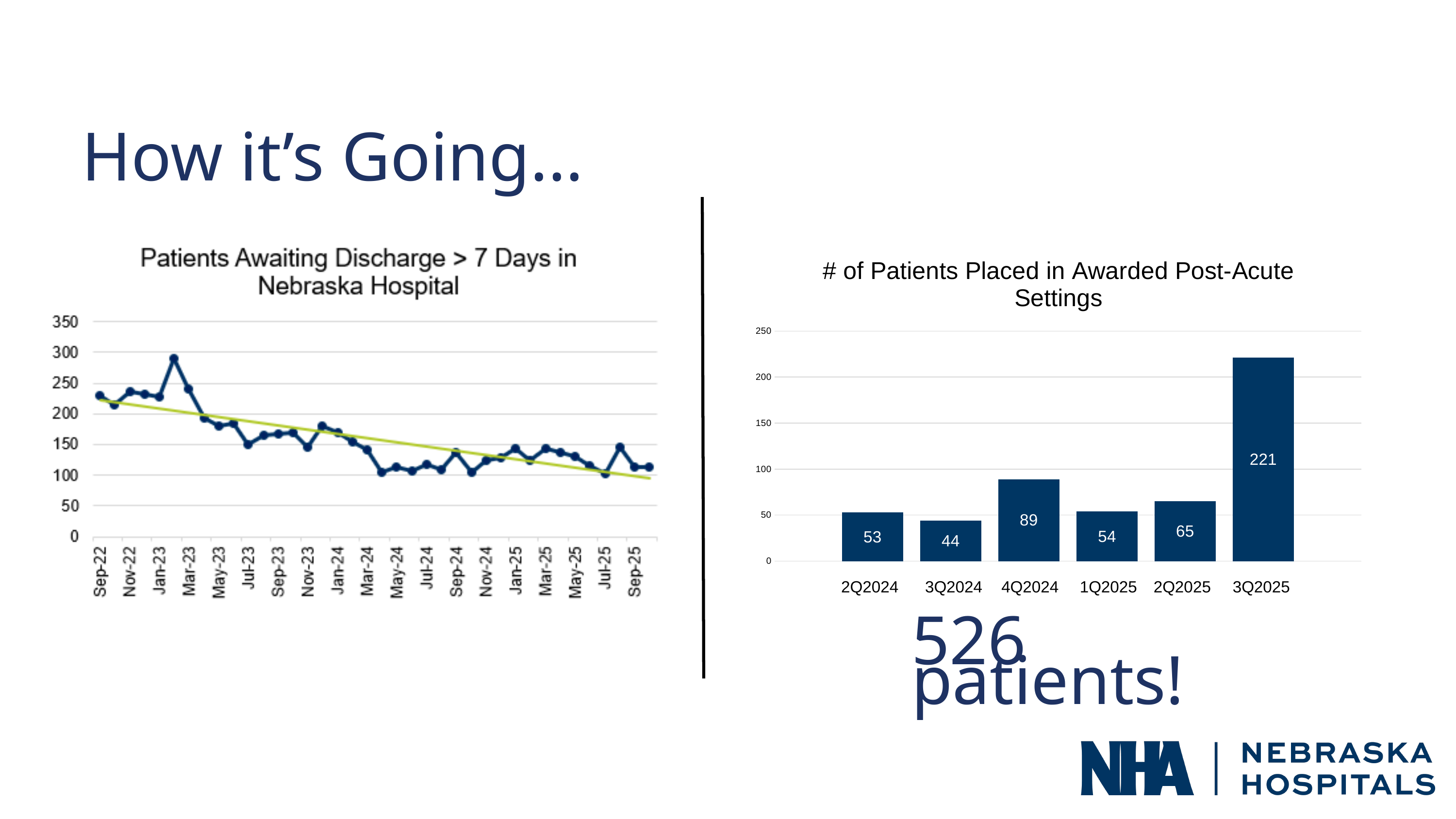
In the '# of Patients Placed in Awarded Post-Acute Settings' chart, what is the difference between the values for 3Q2025 and 2Q2025? 156 In the 'Patients Awaiting Discharge > 7 Days in Nebraska Hospital' chart, is the value for Sep-25 greater or less than 150? less In the '# of Patients Placed in Awarded Post-Acute Settings' chart, which is larger, the value for 2Q2024 or 1Q2025? 1Q2025 In the '# of Patients Placed in Awarded Post-Acute Settings' chart, what is the value for 4Q2024? 89 In the 'Patients Awaiting Discharge > 7 Days in Nebraska Hospital' chart, is the value for Sep-22 greater or less than 200? greater In the '# of Patients Placed in Awarded Post-Acute Settings' chart, which quarter has the lowest value? 3Q2024 In the 'Patients Awaiting Discharge > 7 Days in Nebraska Hospital' chart, do the values generally rise or fall from Sep-22 to Sep-25? fall How many quarters are shown in the '# of Patients Placed in Awarded Post-Acute Settings' chart? 6 In the '# of Patients Placed in Awarded Post-Acute Settings' chart, which quarter has the highest value? 3Q2025 In the '# of Patients Placed in Awarded Post-Acute Settings' chart, what is the value for 3Q2025? 221 What kind of chart is the '# of Patients Placed in Awarded Post-Acute Settings' chart? bar chart What kind of chart is the 'Patients Awaiting Discharge > 7 Days in Nebraska Hospital' chart? line chart